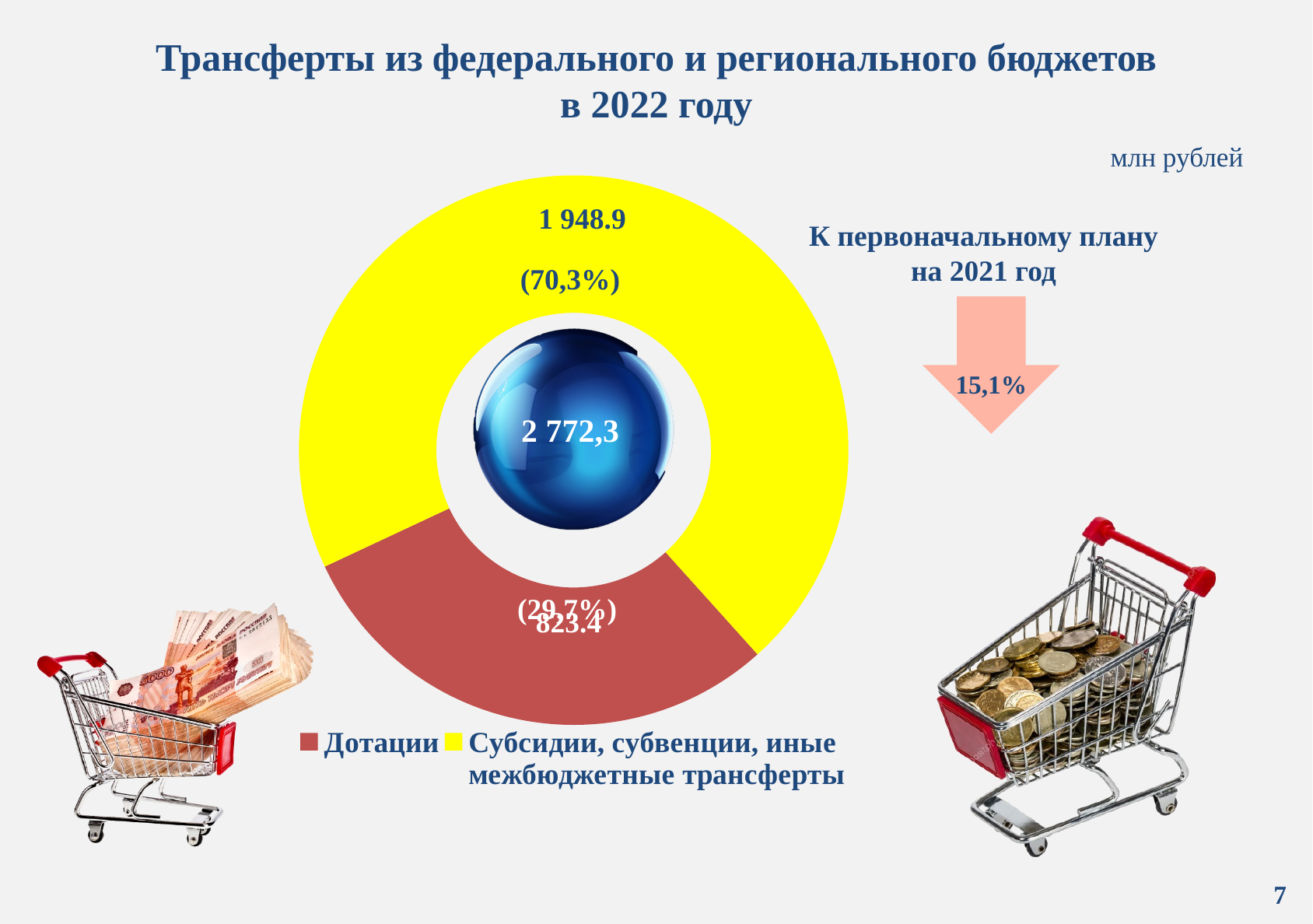
In what units are the chart values given? млн рублей How many categories does the chart show? 2 What is the value for Дотации? 823.4 What share of the total do Субсидии, субвенции, иные межбюджетные трансферты make up? 70,3% Which is larger: Дотации or Субсидии, субвенции, иные межбюджетные трансферты? Субсидии, субвенции, иные межбюджетные трансферты What is the value for Субсидии, субвенции, иные межбюджетные трансферты? 1 948.9 What kind of chart is shown on the slide? doughnut (pie) chart What total value is shown in the centre of the chart? 2 772,3 What share of the total do Дотации make up? 29,7% What colour is the Дотации slice? red Which category is the largest in the chart? Субсидии, субвенции, иные межбюджетные трансферты Which category is the smallest in the chart? Дотации